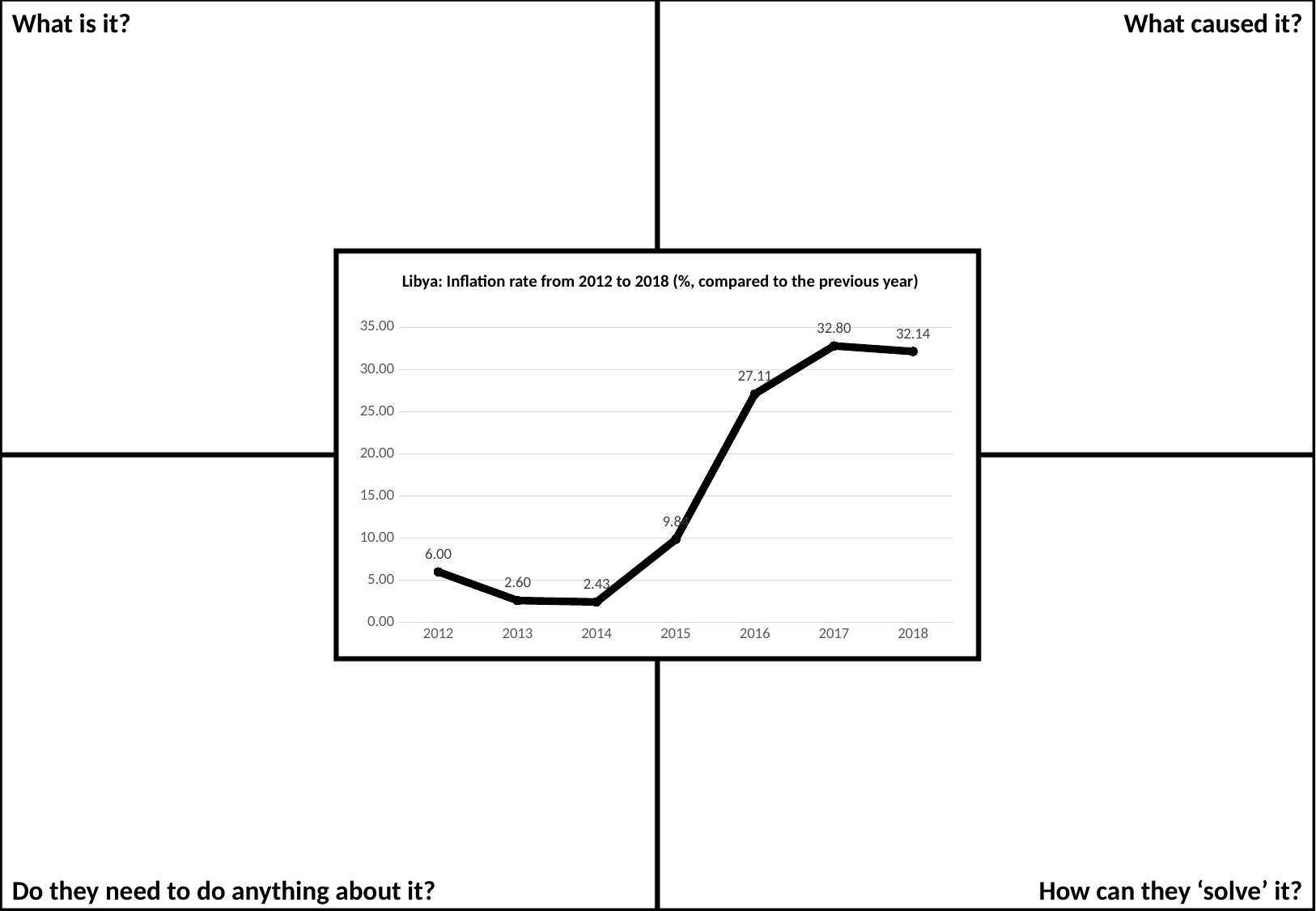
What is the inflation rate shown for 2016? 27.11 What is the difference between the inflation rate in 2015 and in 2014? 7.41 Is the inflation rate for 2016 greater or less than 25.00? greater What is the inflation rate shown for 2018? 32.14 How many years are plotted on the chart? 7 Which year has a higher inflation rate, 2013 or 2015? 2015 Which year has the lowest inflation rate? 2014 Which year has the highest inflation rate? 2017 What is the inflation rate shown for 2012? 6.00 What is the difference between the inflation rate in 2017 and in 2016? 5.69 What kind of chart is shown on the slide? Line chart What is the title of the chart? Libya: Inflation rate from 2012 to 2018 (%, compared to the previous year)